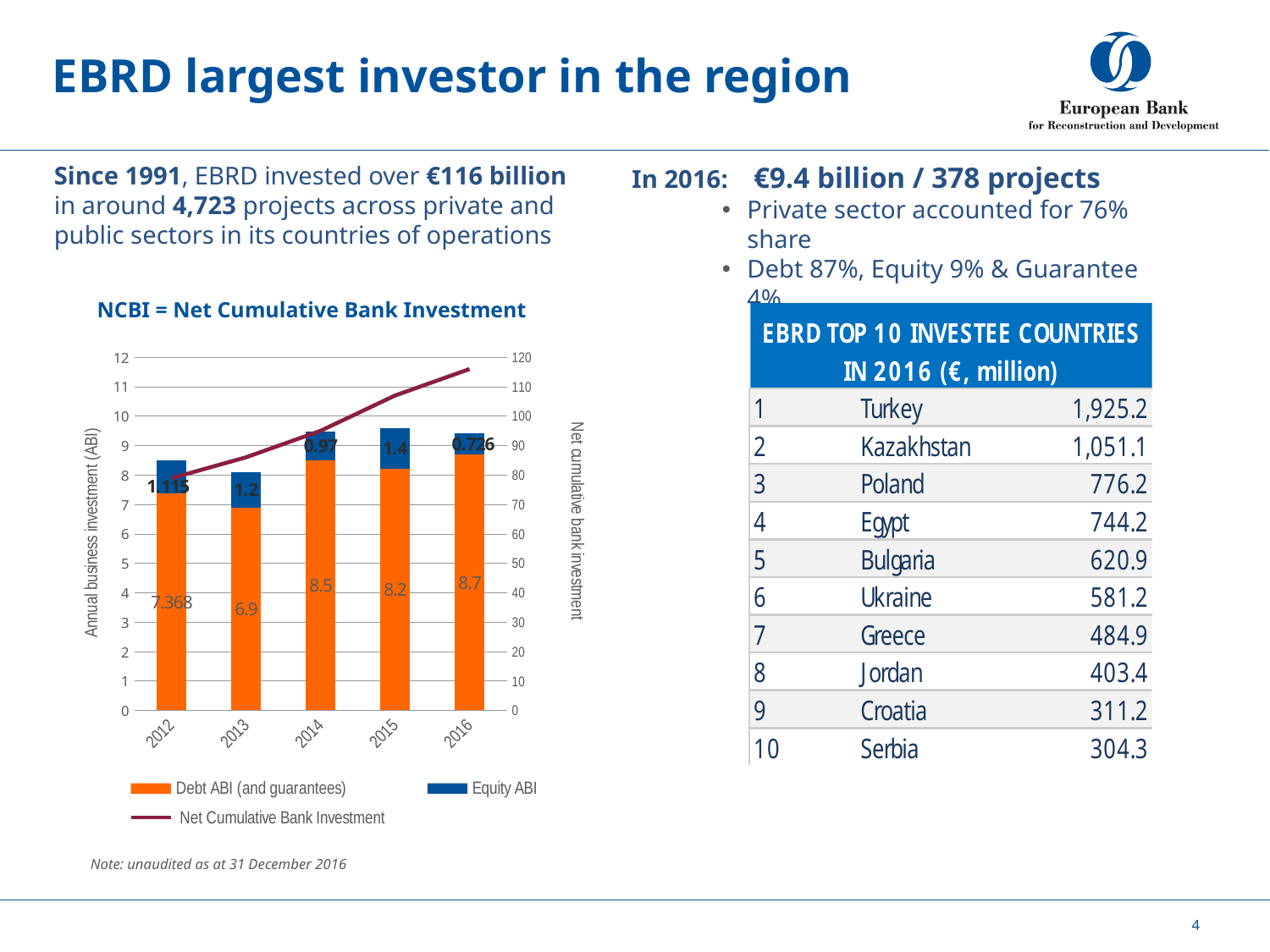
Which year has the lowest Debt ABI (and guarantees) value? 2013 Which year has the highest Debt ABI (and guarantees) value? 2016 How many years are shown on the x axis of the chart? 5 Which year has the larger Debt ABI (and guarantees) value, 2014 or 2015? 2014 What is the Equity ABI value for 2015? 1.4 What is the Debt ABI (and guarantees) value for 2014? 8.5 How many series does the chart legend list? 3 Does the Net Cumulative Bank Investment line rise or fall from 2012 to 2016? rise Is the Net Cumulative Bank Investment value for 2016 greater or less than 110? greater What is the total of the stacked bar for 2015 (Debt ABI plus Equity ABI)? 9.6 What is the difference between the Debt ABI (and guarantees) values for 2016 and 2013? 1.8 Which year has the lowest Equity ABI value? 2016